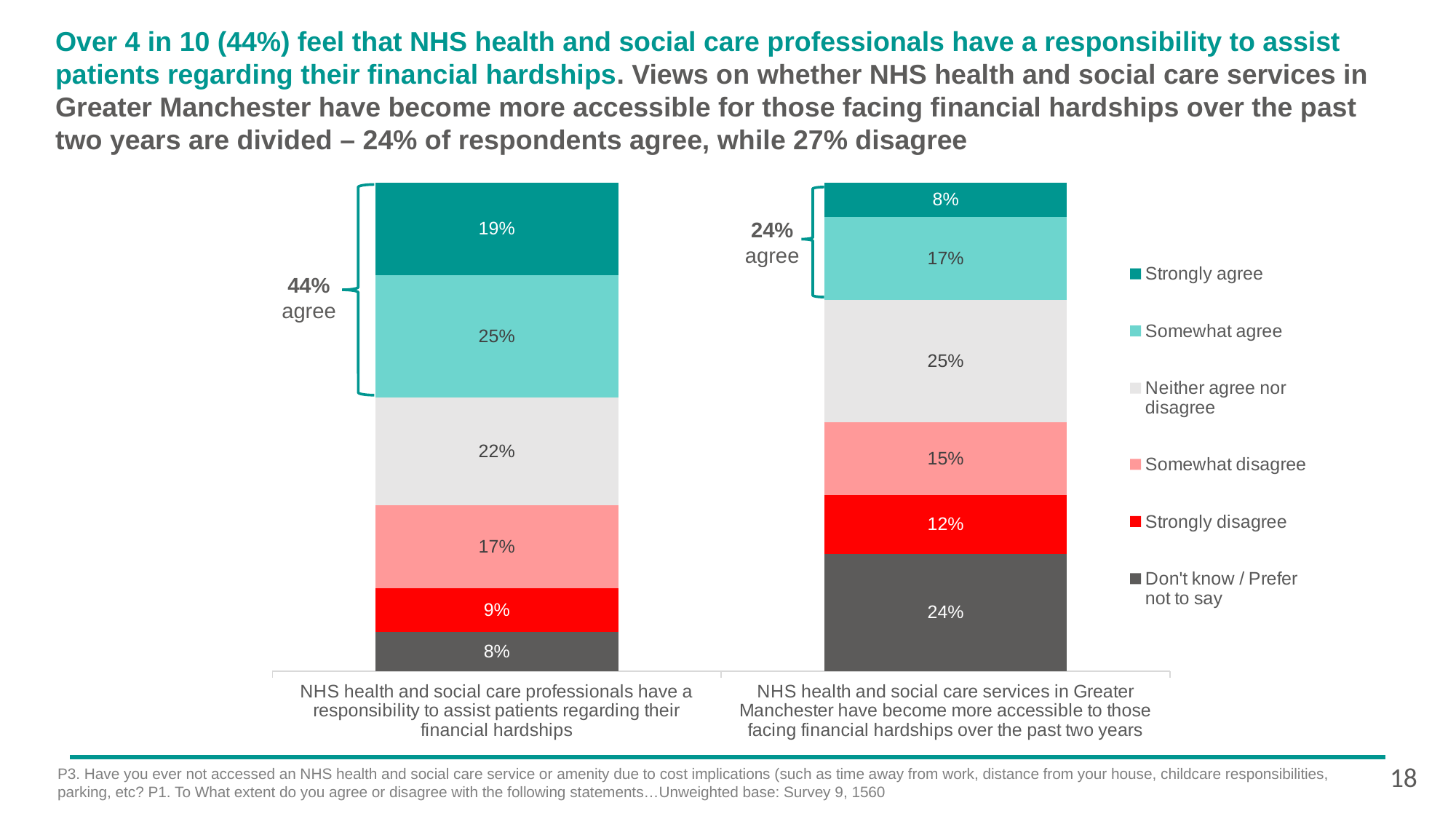
Which response category has the largest share for the statement that NHS health and social care professionals have a responsibility to assist patients regarding their financial hardships? Somewhat agree Which statement has the larger 'Strongly disagree' share: professionals having a responsibility to assist patients, or services becoming more accessible over the past two years? Services becoming more accessible over the past two years How many statements are shown as bars in the chart? 2 What colour represents 'Strongly disagree' in the chart? Red Which response category has the smallest share for the statement that NHS health and social care professionals have a responsibility to assist patients regarding their financial hardships? Don't know / Prefer not to say How many percentage points higher is 'Strongly agree' for the statement about professionals having a responsibility to assist patients than for the statement about services becoming more accessible? 11 percentage points What percentage answered 'Don't know / Prefer not to say' for the statement that NHS health and social care services in Greater Manchester have become more accessible to those facing financial hardships over the past two years? 24% What percentage strongly agree that NHS health and social care professionals have a responsibility to assist patients regarding their financial hardships? 19% How many response categories does the legend list? 6 What percentage neither agree nor disagree that NHS health and social care services in Greater Manchester have become more accessible to those facing financial hardships? 25% What kind of chart is shown on the slide? Stacked bar chart What is the combined share of 'Strongly agree' and 'Somewhat agree' for the statement that NHS health and social care professionals have a responsibility to assist patients regarding their financial hardships? 44%